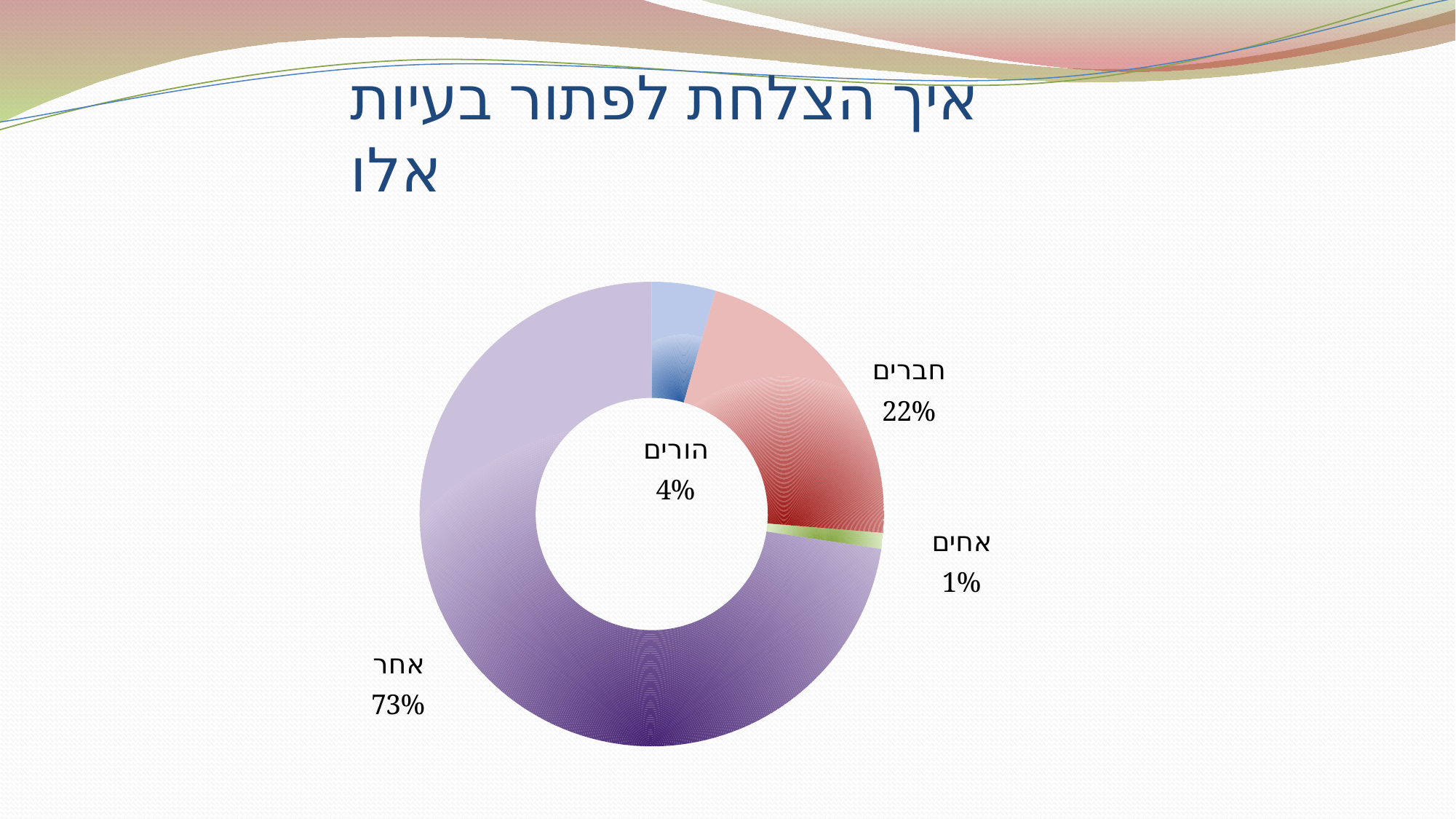
What is the difference in percentage points between הורים and אחים? 3 Which is larger, the share for חברים or the share for הורים? חברים Which category has the largest share of the chart? אחר What is the difference in percentage points between אחר and חברים? 51 What percentage is shown for חברים (friends)? 22% What percentage is shown for אחים (siblings)? 1% What kind of chart is shown on the slide? Doughnut chart What percentage is shown for הורים (parents)? 4% What share of the chart does אחר (other) account for? 73% Which category has the smallest share of the chart? אחים What is the title of the slide? איך הצלחת לפתור בעיות אלו How many categories are shown in the chart? 4